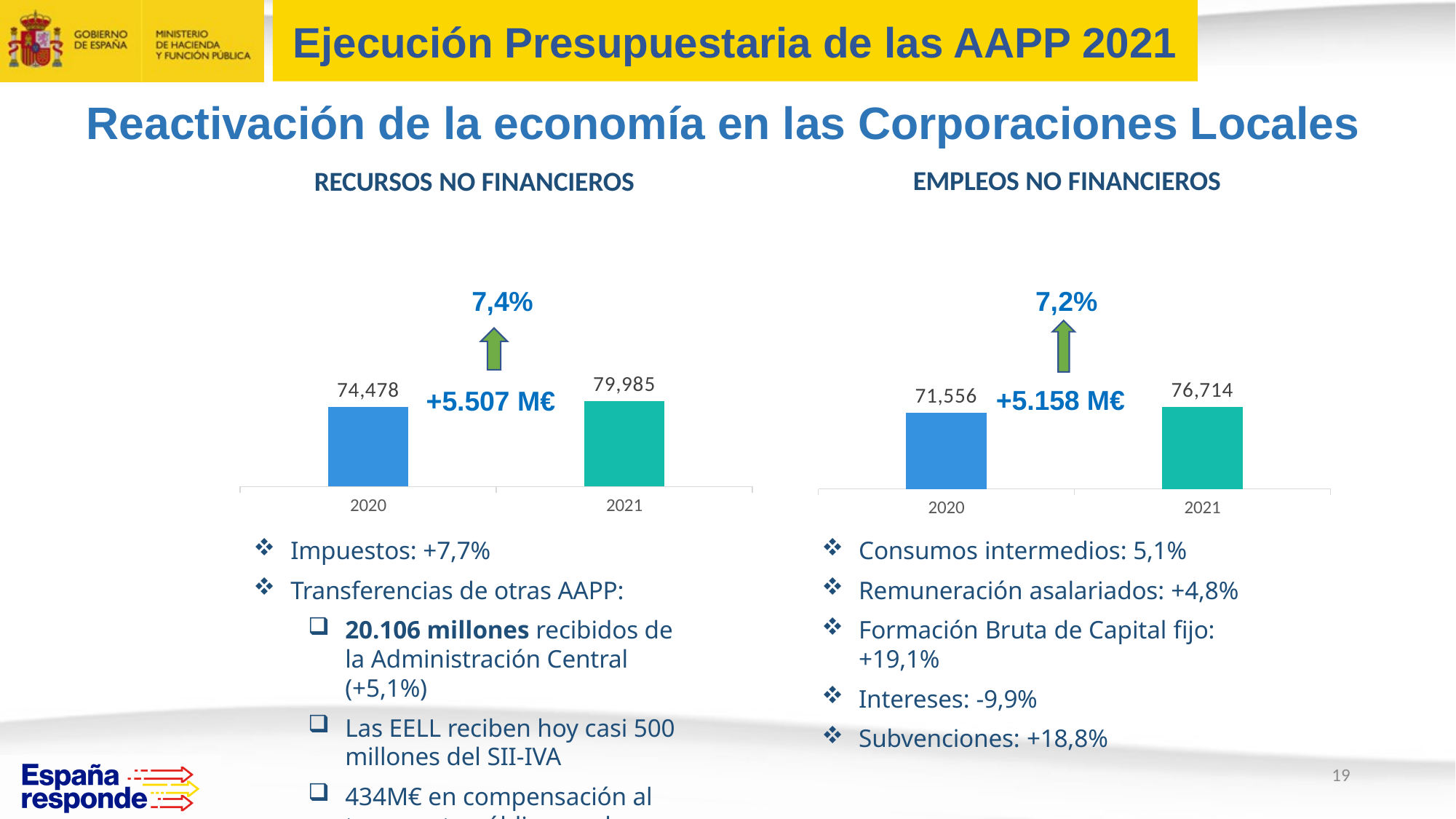
What percentage increase is shown above the arrow in the EMPLEOS NO FINANCIEROS chart? 7,2% In the RECURSOS NO FINANCIEROS chart, what is the value for 2020? 74,478 In the EMPLEOS NO FINANCIEROS chart, what is the value for 2020? 71,556 How many bars are shown in the EMPLEOS NO FINANCIEROS chart? 2 In the EMPLEOS NO FINANCIEROS chart, what is the difference between the 2021 and 2020 values? 5,158 In the RECURSOS NO FINANCIEROS chart, what is the value for 2021? 79,985 Is the 2021 value in the RECURSOS NO FINANCIEROS chart larger or smaller than the 2021 value in the EMPLEOS NO FINANCIEROS chart? larger In the RECURSOS NO FINANCIEROS chart, which year has the higher value? 2021 In the EMPLEOS NO FINANCIEROS chart, which year has the lower value? 2020 In the RECURSOS NO FINANCIEROS chart, what is the difference between the 2021 and 2020 values? 5,507 In the EMPLEOS NO FINANCIEROS chart, what is the value for 2021? 76,714 What type of chart is the RECURSOS NO FINANCIEROS chart? bar chart